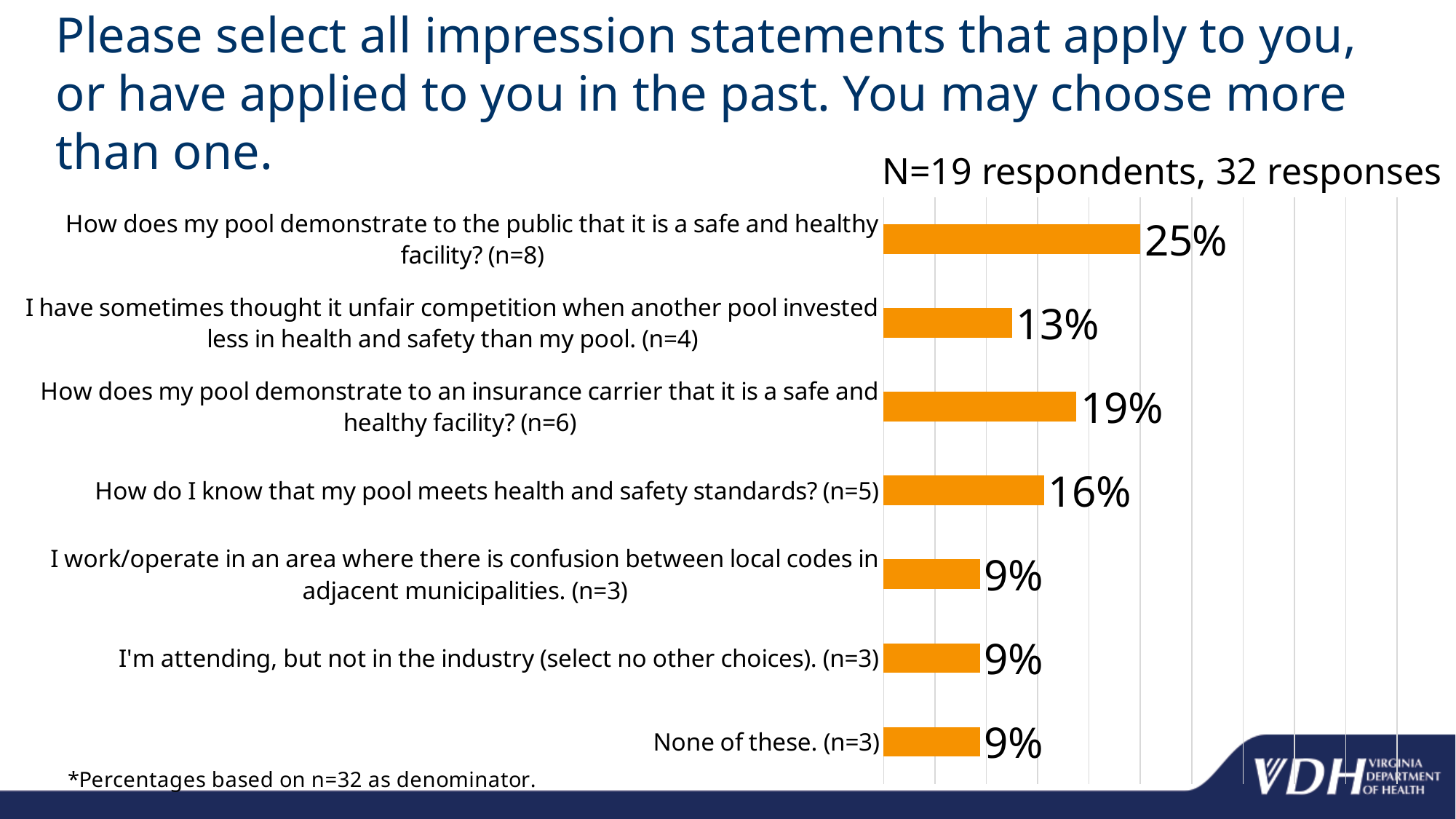
What percentage is shown for "None of these."? 9% What is the difference in percentage points between the public safe-and-healthy-facility statement and the insurance carrier statement? 6 How many respondents does the chart note say there were? 19 What kind of chart is shown on the slide? Bar chart What colour are the bars in the chart? Orange What percentage is shown for "How do I know that my pool meets health and safety standards?"? 16% Which is larger: the percentage for the insurance carrier statement or the percentage for the unfair competition statement? The insurance carrier statement How many impression statements (categories) are plotted in the chart? 7 Which impression statement has the highest percentage? How does my pool demonstrate to the public that it is a safe and healthy facility? How many statements share the lowest percentage of 9%? 3 What percentage is shown for "How does my pool demonstrate to the public that it is a safe and healthy facility?"? 25% What percentage is shown for "I have sometimes thought it unfair competition when another pool invested less in health and safety than my pool."? 13%